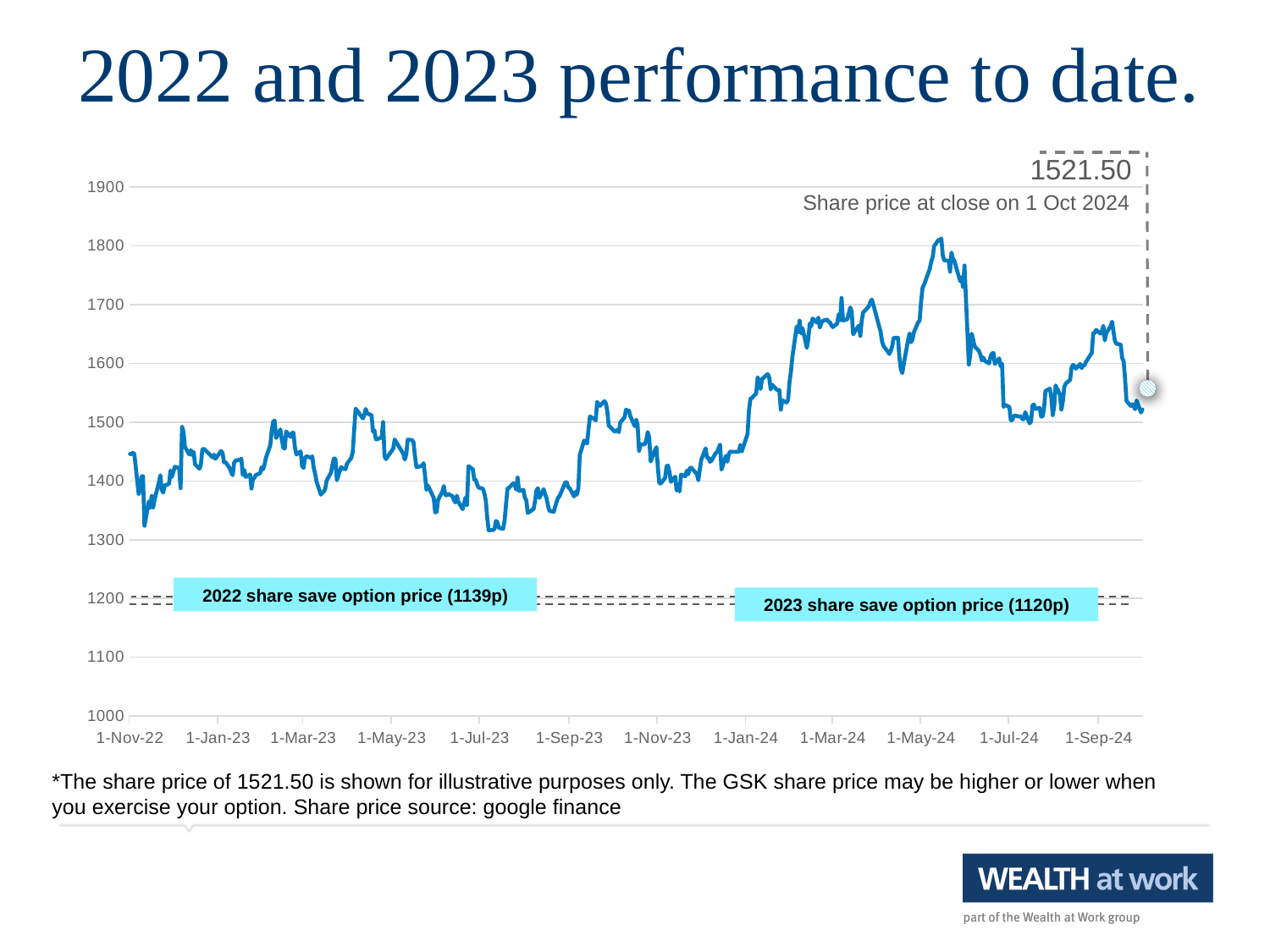
How many date labels are shown on the x axis? 12 What is the 2022 share save option price shown on the chart? 1139p Is the share price at close on 1 Oct 2024 greater or less than the 2022 share save option price? greater What is the share price at close on 1 Oct 2024 shown on the chart? 1521.50 Is the highest point of the share price line greater or less than 1700? greater What is the title of the slide? 2022 and 2023 performance to date. What is the difference between the 2022 share save option price and the 2023 share save option price? 19p What kind of chart is shown on the slide? line chart Which share save option price is higher, 2022 or 2023? 2022 Does the share price line generally rise or fall between 1-Jan-24 and 1-May-24? rise Is the lowest point of the share price line, around July 2023, greater or less than 1400? less What is the 2023 share save option price shown on the chart? 1120p